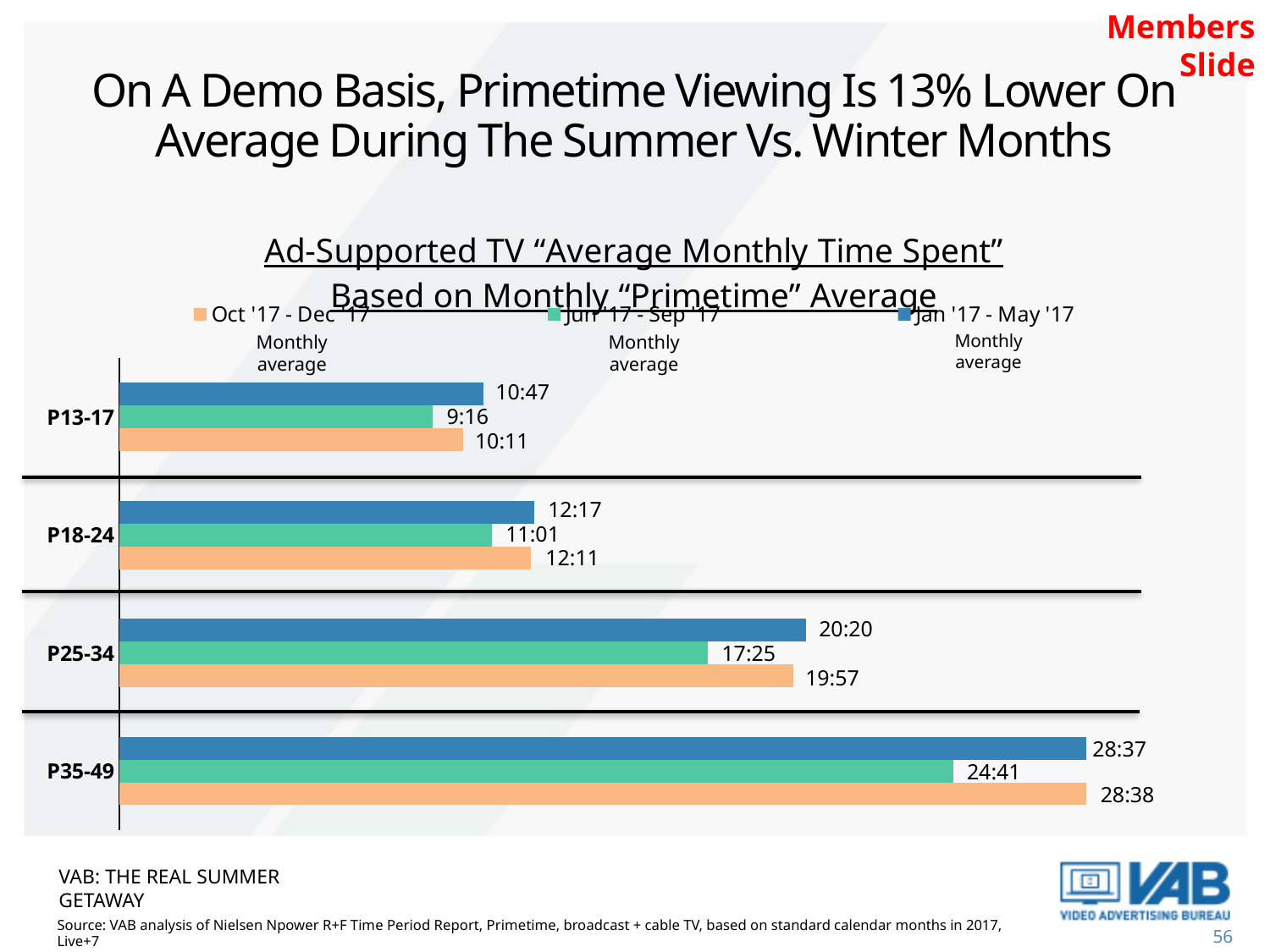
Which demo has the lowest Jan '17 - May '17 monthly average? P13-17 What is the Oct '17 - Dec '17 monthly average for P18-24? 12:11 For P25-34, which period has the lowest monthly average? Jun '17 - Sep '17 For P25-34, which is larger: the Jan '17 - May '17 average or the Jun '17 - Sep '17 average? Jan '17 - May '17 Which demo has the highest Jun '17 - Sep '17 monthly average? P35-49 What is the Oct '17 - Dec '17 monthly average for P35-49? 28:38 What type of chart is shown on the slide? Bar chart What is the Jan '17 - May '17 monthly average for P25-34? 20:20 How many series does the legend list? 3 How many demo groups are shown in the chart? 4 What is the Jun '17 - Sep '17 monthly average for P13-17? 9:16 What is the Jun '17 - Sep '17 monthly average for P18-24? 11:01